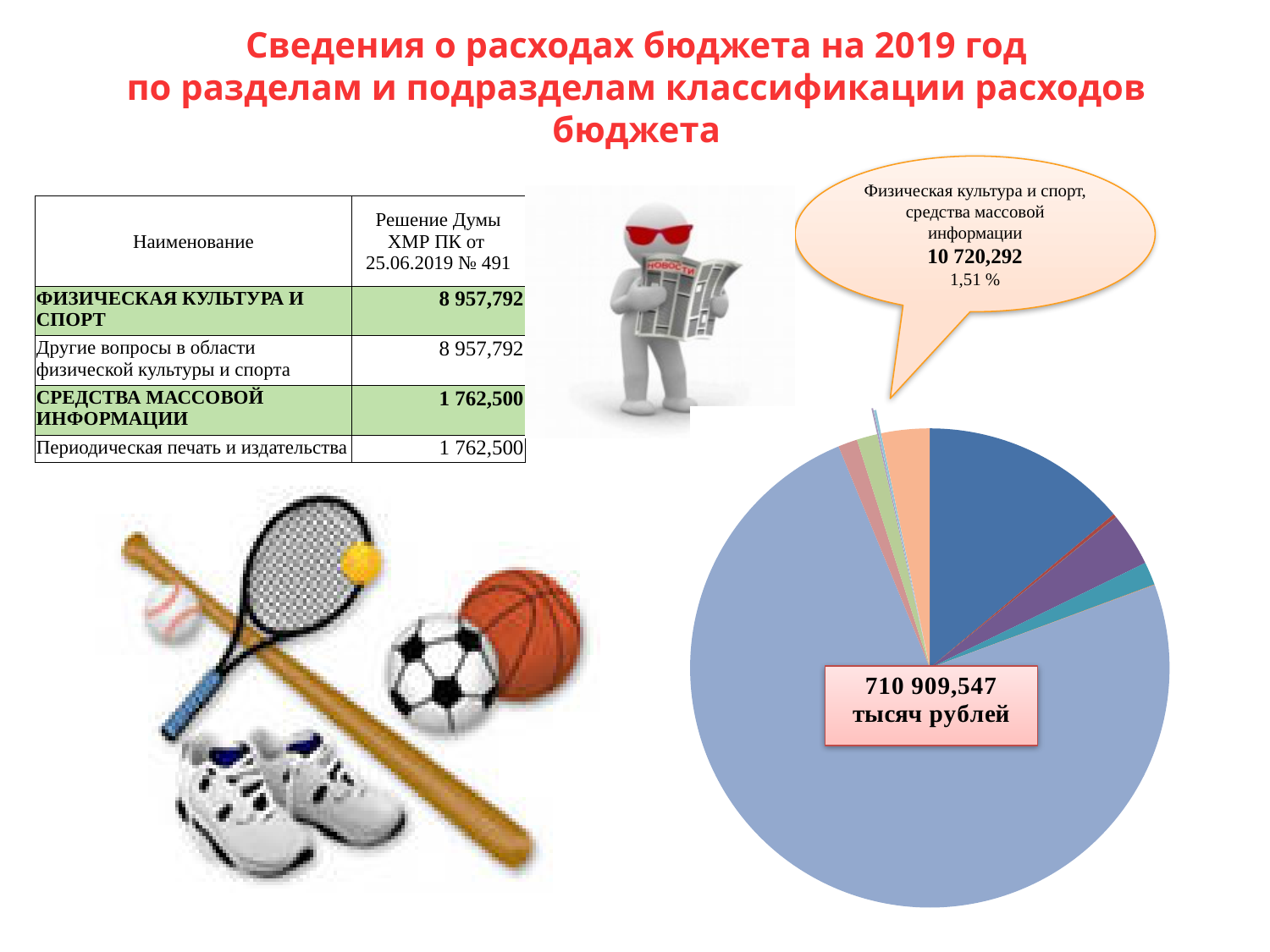
What value does the callout give for the slice "Физическая культура и спорт, средства массовой информации"? 10 720,292 What is the title of the slide containing the pie chart? Сведения о расходах бюджета на 2019 год по разделам и подразделам классификации расходов бюджета What total amount is printed in the box on the pie chart? 710 909,547 тысяч рублей Does the slice for "Физическая культура и спорт, средства массовой информации" take up more or less than half of the pie? less Is the slice labelled by the callout (1,51 %) the largest slice of the pie? No Does the pie chart have a legend? No What share of the pie does the slice "Физическая культура и спорт, средства массовой информации" represent, according to the callout? 1,51 % What kind of chart is shown on the slide? pie chart